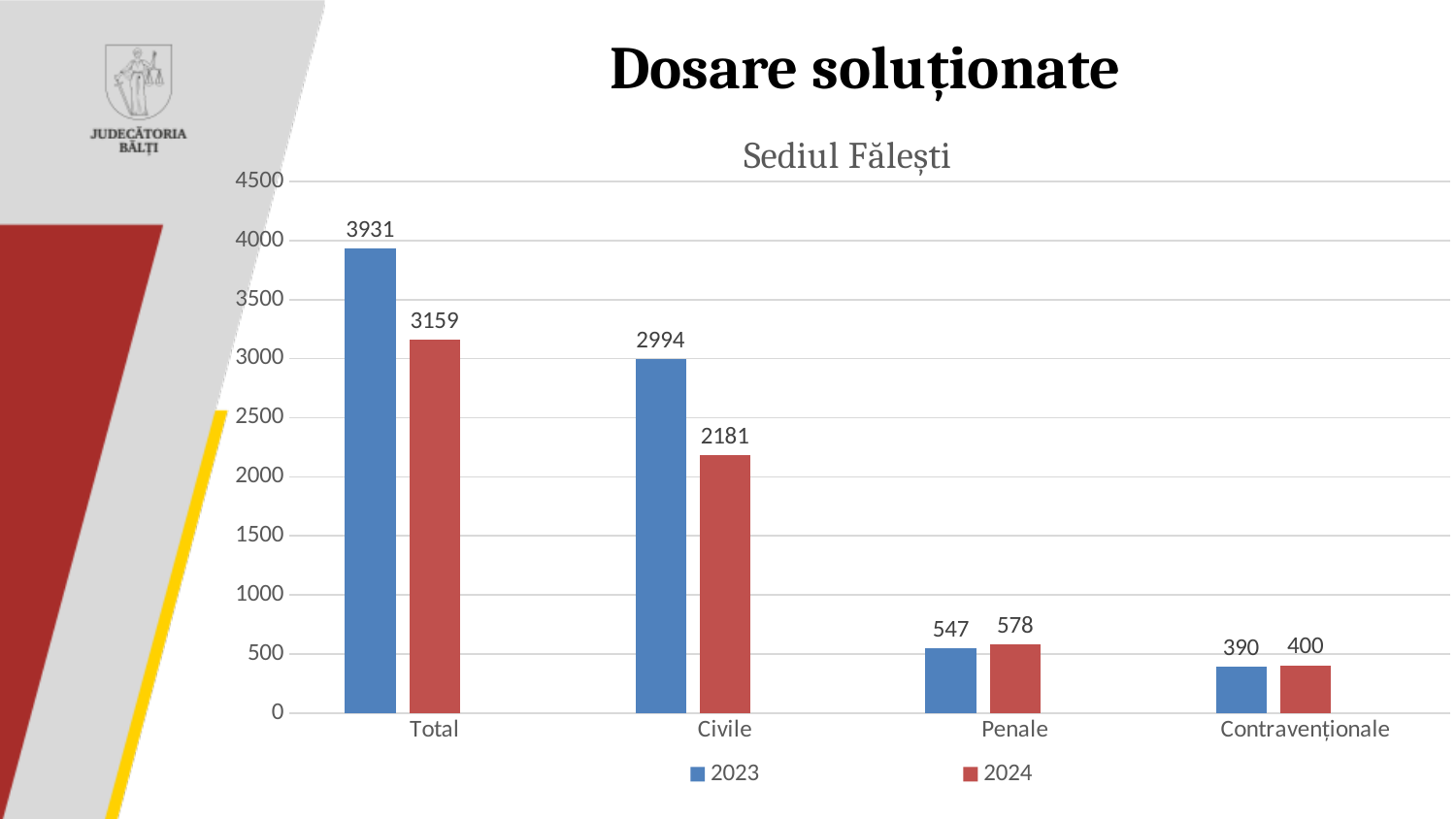
What type of chart is shown on the slide? Bar chart Which category has the lowest value in the 2024 series? Contravenționale What is the value for Civile in 2023? 2994 How many series does the legend list? 2 What is the difference between the 2023 and 2024 values for Total? 772 Which is larger for Penale: the 2023 value or the 2024 value? 2024 What is the value for Total in 2024? 3159 Which category has the highest value in the 2023 series? Total What is the value for Penale in 2024? 578 What is the difference between the 2023 and 2024 values for Civile? 813 How many categories are shown on the x axis? 4 What is the value for Contravenționale in 2023? 390